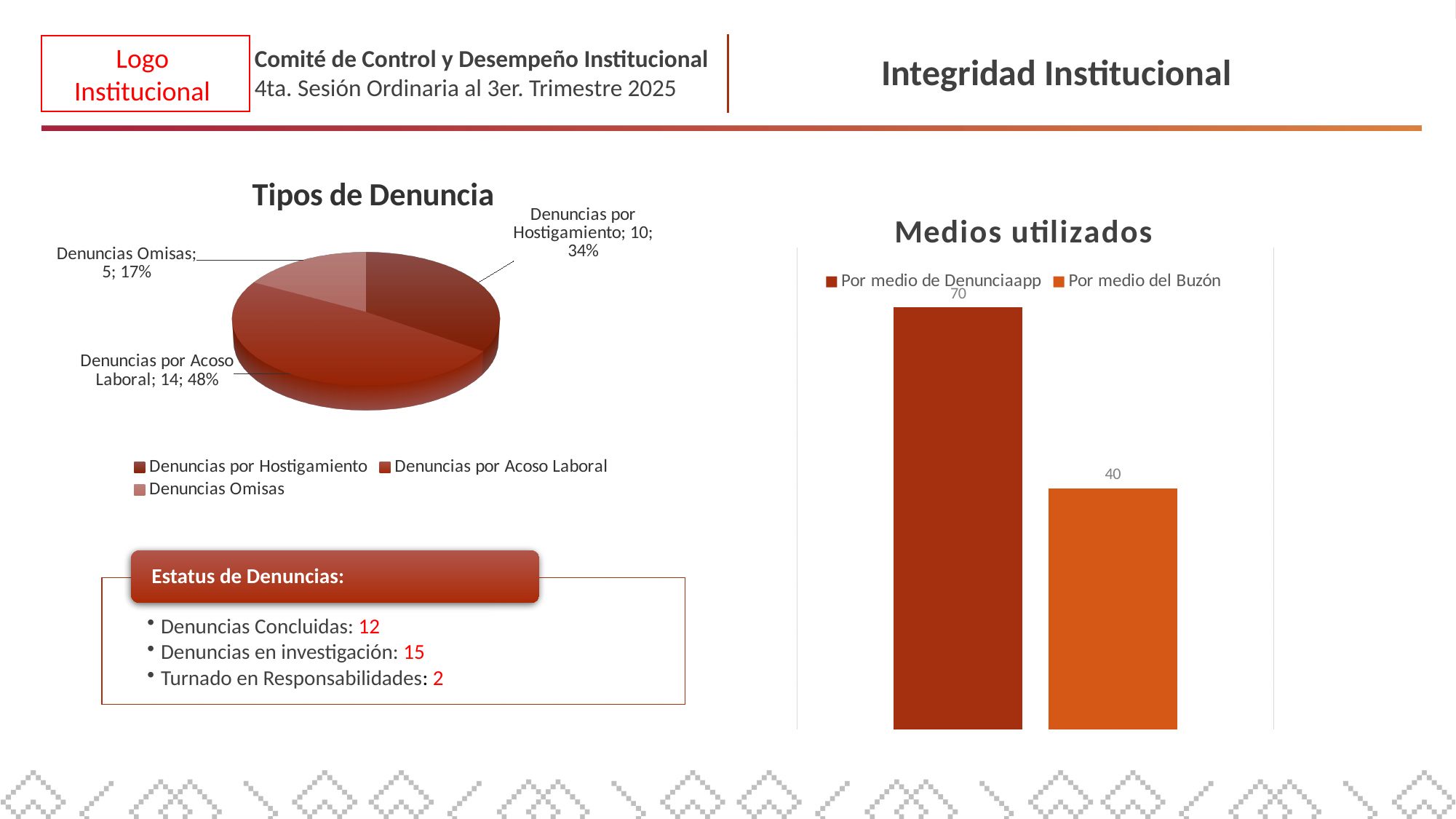
In the 'Tipos de Denuncia' chart, what is the difference between the counts for 'Denuncias por Acoso Laboral' and 'Denuncias Omisas'? 9 In the 'Medios utilizados' chart, what is the difference between 'Por medio de Denunciaapp' and 'Por medio del Buzón'? 30 In the 'Tipos de Denuncia' chart, which category has the smallest slice? Denuncias Omisas In the 'Medios utilizados' chart, how many series does the legend list? 2 In the 'Tipos de Denuncia' chart, what kind of chart is shown? pie chart In the 'Medios utilizados' chart, what is the value for 'Por medio de Denunciaapp'? 70 In the 'Tipos de Denuncia' chart, how many denuncias are 'Denuncias por Acoso Laboral'? 14 In the 'Tipos de Denuncia' chart, how many categories does the legend list? 3 In the 'Medios utilizados' chart, what is the value for 'Por medio del Buzón'? 40 In the 'Tipos de Denuncia' chart, which category has the largest slice? Denuncias por Acoso Laboral In the 'Medios utilizados' chart, what kind of chart is shown? bar chart In the 'Tipos de Denuncia' chart, what percentage share does 'Denuncias por Hostigamiento' have? 34%